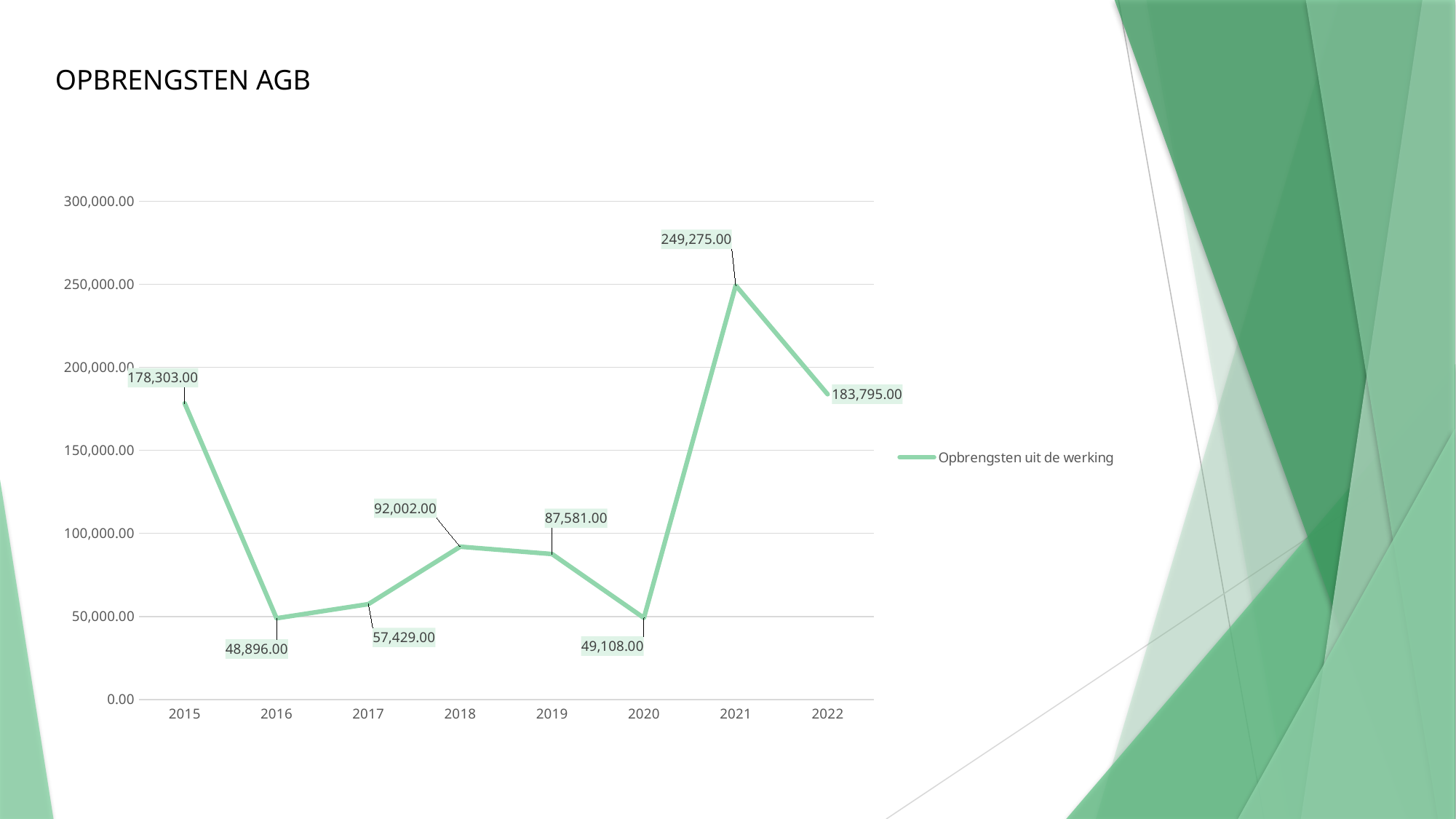
What is the value for 2016? 48,896.00 What is the value for 2021? 249,275.00 What is the name of the series shown in the legend? Opbrengsten uit de werking What is the difference between the values for 2021 and 2022? 65,480.00 What is the value for 2018? 92,002.00 Which year has the highest value? 2021 Which is larger, the value for 2015 or the value for 2022? 2022 Which year has the lowest value? 2016 How many years are plotted on the x axis? 8 What type of chart is shown on the slide? line chart What is the value for 2022? 183,795.00 What is the difference between the values for 2018 and 2019? 4,421.00